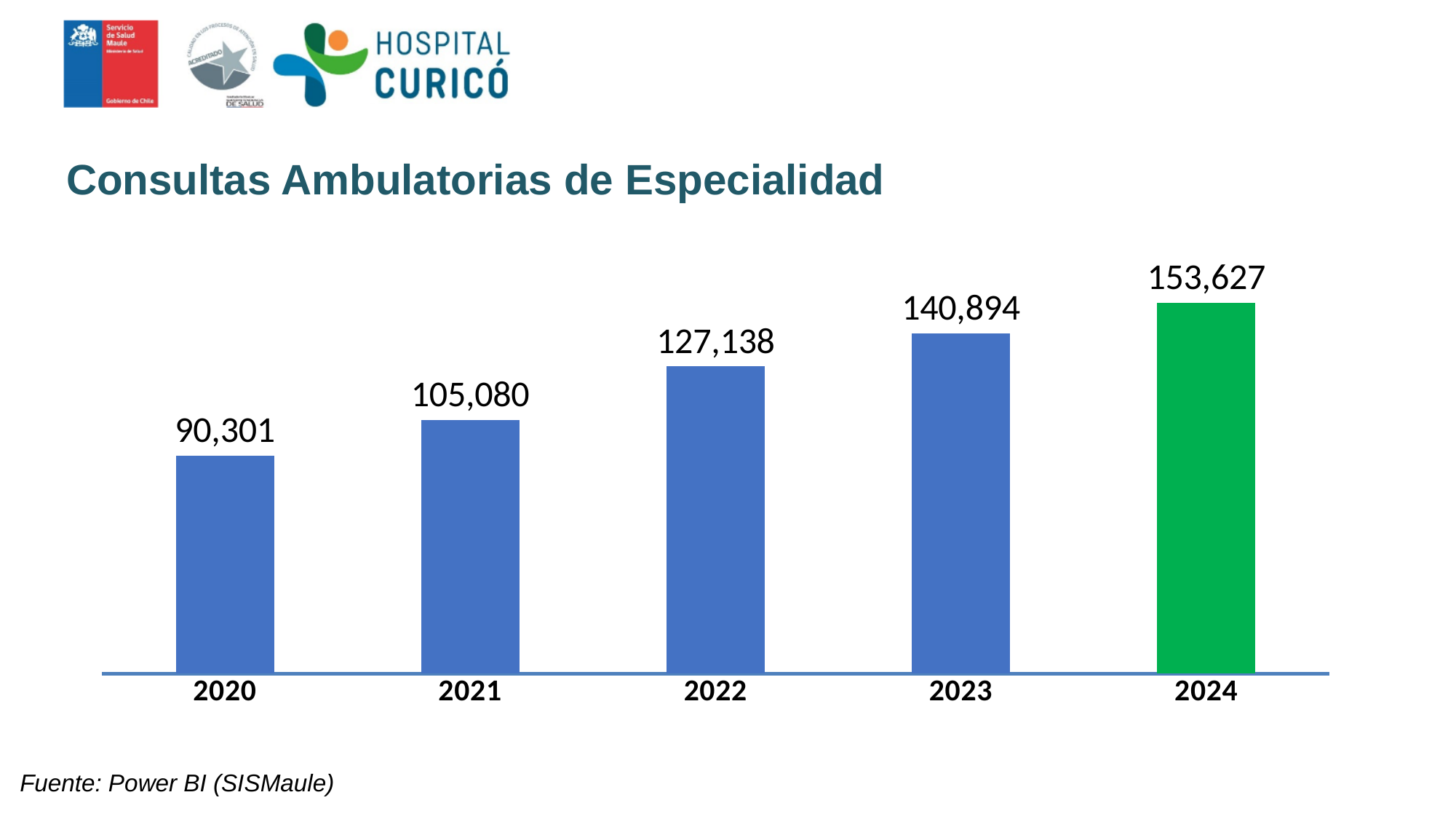
Which is larger, the value for 2022 or the value for 2021? 2022 Which year has the highest value? 2024 How many years are shown on the chart? 5 What is the value for 2020? 90,301 What is the difference between the values for 2024 and 2023? 12,733 What kind of chart is shown on the slide? bar chart What is the value for 2024? 153,627 Do the values rise or fall from 2020 to 2024? rise Which year has the lowest value? 2020 Which year's bar is coloured green? 2024 What is the value for 2022? 127,138 What is the difference between the values for 2021 and 2020? 14,779